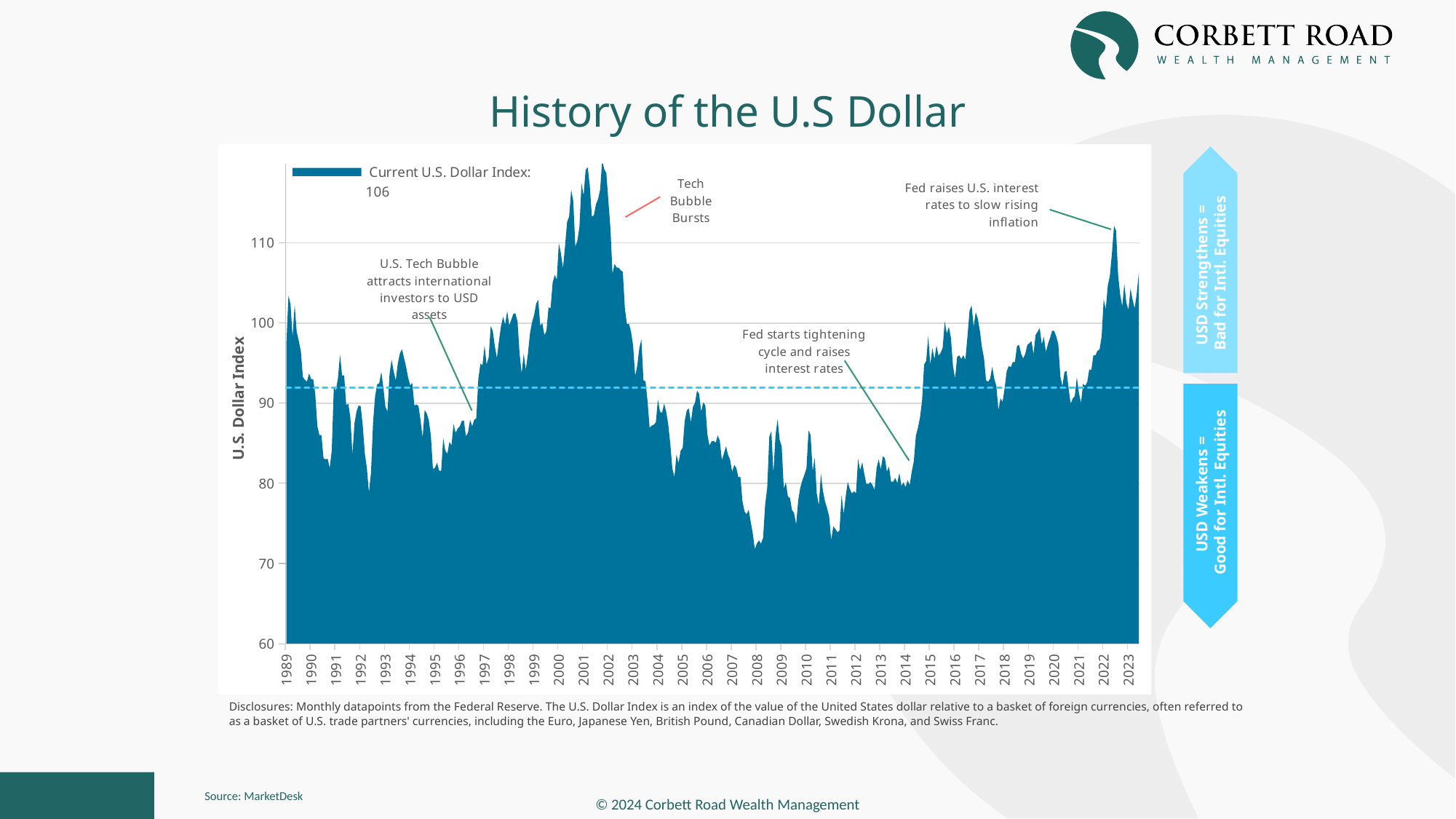
What event is annotated at the highest peak of the chart around 2001–2002? Tech Bubble Bursts How many year labels are shown on the x axis of the chart? 35 Which low point of the U.S. Dollar Index is lower: the one in 2008 or the one in 1992? 2008 Is the U.S. Dollar Index value at its low point in 2008 greater or less than 80? less Does the U.S. Dollar Index generally rise or fall between 2002 and 2008? Fall What is the current U.S. Dollar Index value shown in the chart legend? 106 Does the U.S. Dollar Index rise or fall between 2014 and 2015? Rise What is the title of the slide's chart? History of the U.S Dollar Which peak of the U.S. Dollar Index is higher: the one around 2001–2002 or the one in 2022? Around 2001–2002 Is the U.S. Dollar Index value at its peak around 2001–2002 greater or less than 110? greater What kind of chart is shown on the slide? Area chart Is the U.S. Dollar Index value in 2014, where the 'Fed starts tightening cycle' annotation points, greater or less than 90? less